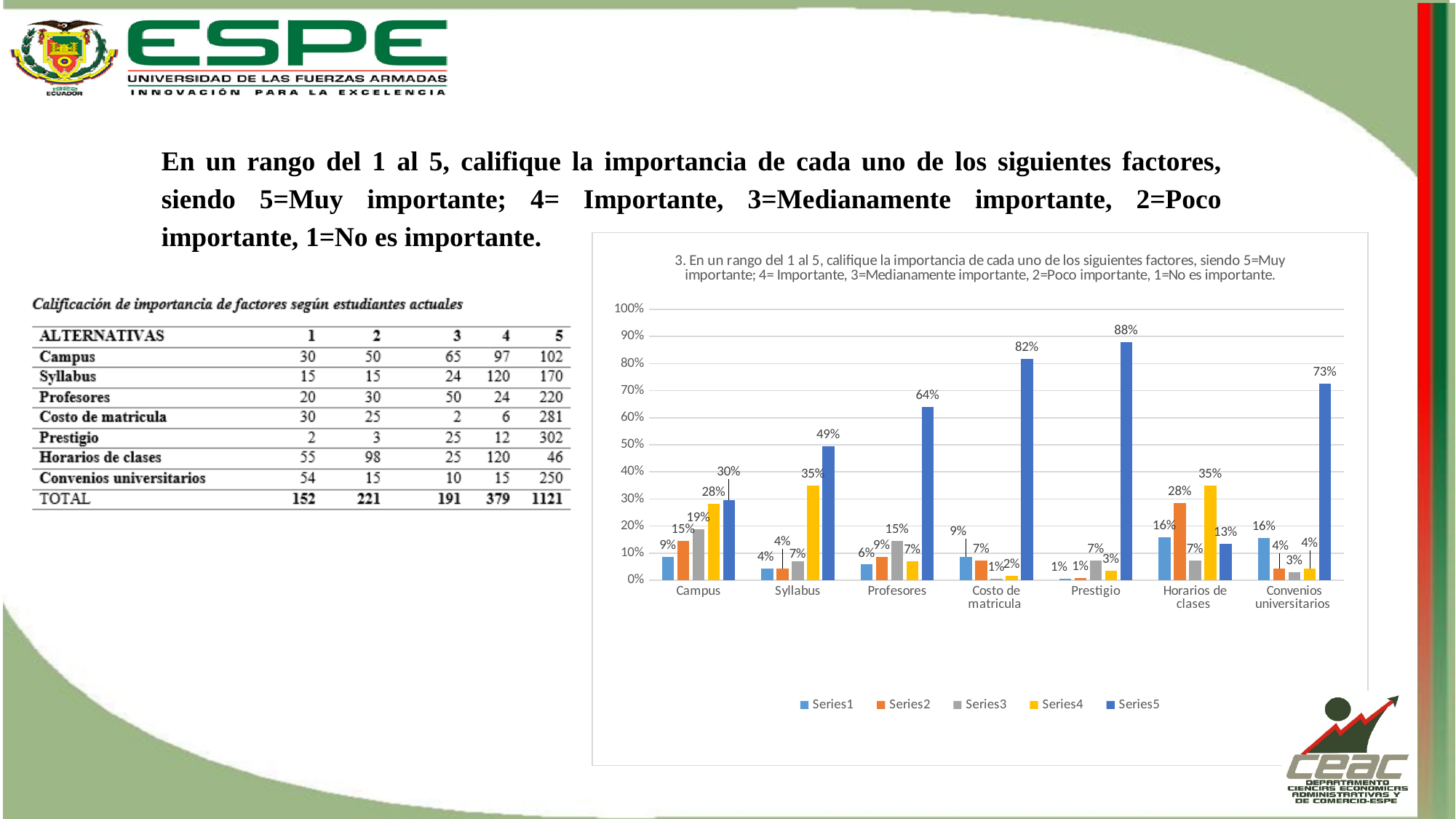
Which category has the lowest Series5 value? Horarios de clases What is the Series5 value for Prestigio? 88% Which is larger, the Series4 value for Syllabus or the Series4 value for Campus? Syllabus What is the difference between the Series5 values for Costo de matricula and Profesores? 18% What colour are the Series5 bars? blue How many series does the legend list? 5 What kind of chart is shown on the slide? bar chart What is the Series2 value for Campus? 15% How many categories are shown on the x axis? 7 What is the Series4 value for Horarios de clases? 35% Which category has the highest Series5 value? Prestigio Is the Series5 value for Convenios universitarios greater or less than 70%? greater